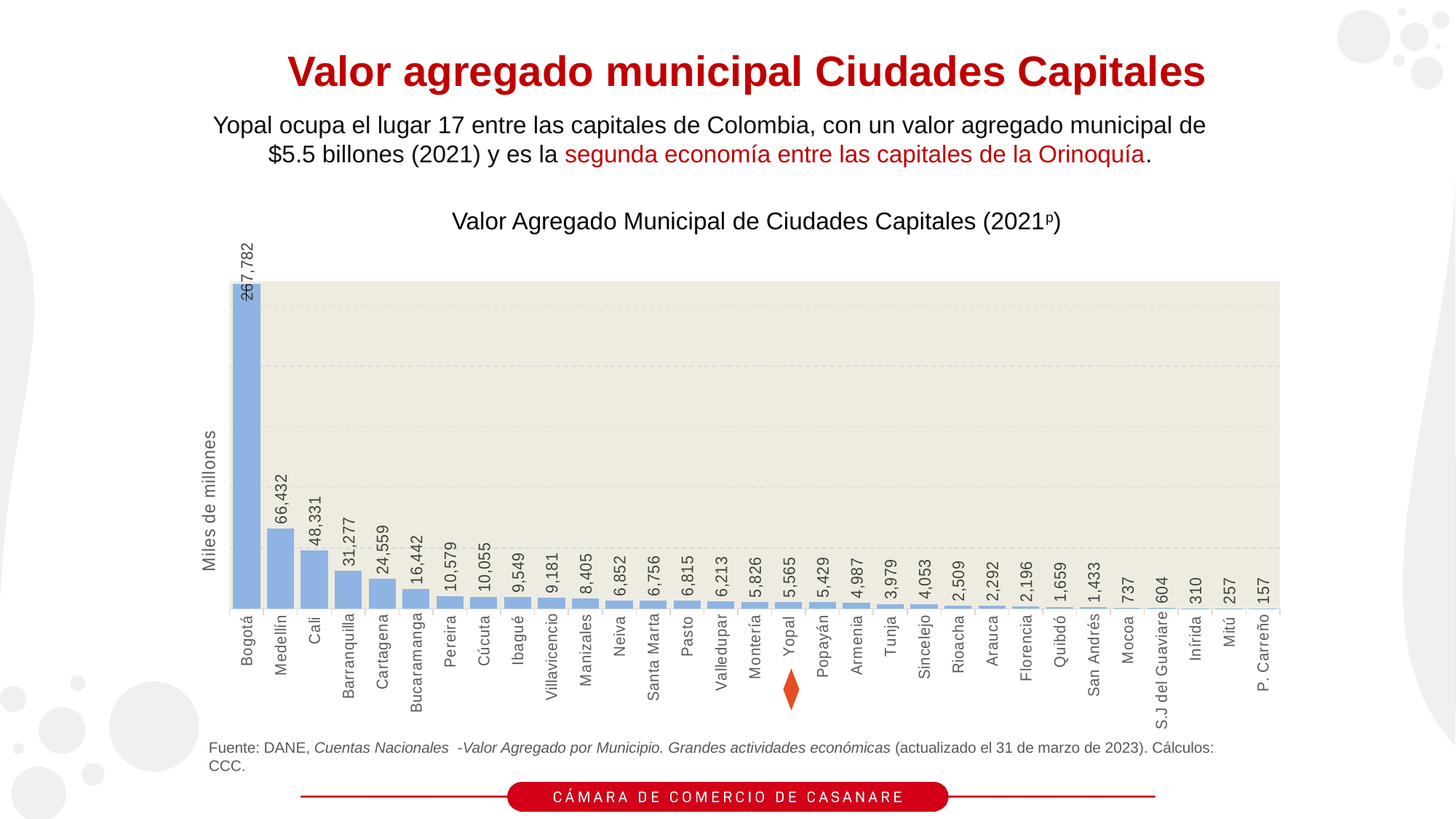
What is the value for Villavicencio? 9,181 How many cities are shown in the chart? 31 What is the value for Yopal? 5,565 Do the values rise or fall from left to right along the x axis? Fall What is the value for Arauca? 2,292 Which city has the highest value? Bogotá What is the difference between the values for Bogotá and Medellín? 201,350 What kind of chart is shown? Bar chart What is the label on the vertical axis of the chart? Miles de millones What is the difference between the values for Medellín and Cali? 18,101 Which has a larger value, Pasto or Santa Marta? Pasto Which city has the lowest value? P. Carreño